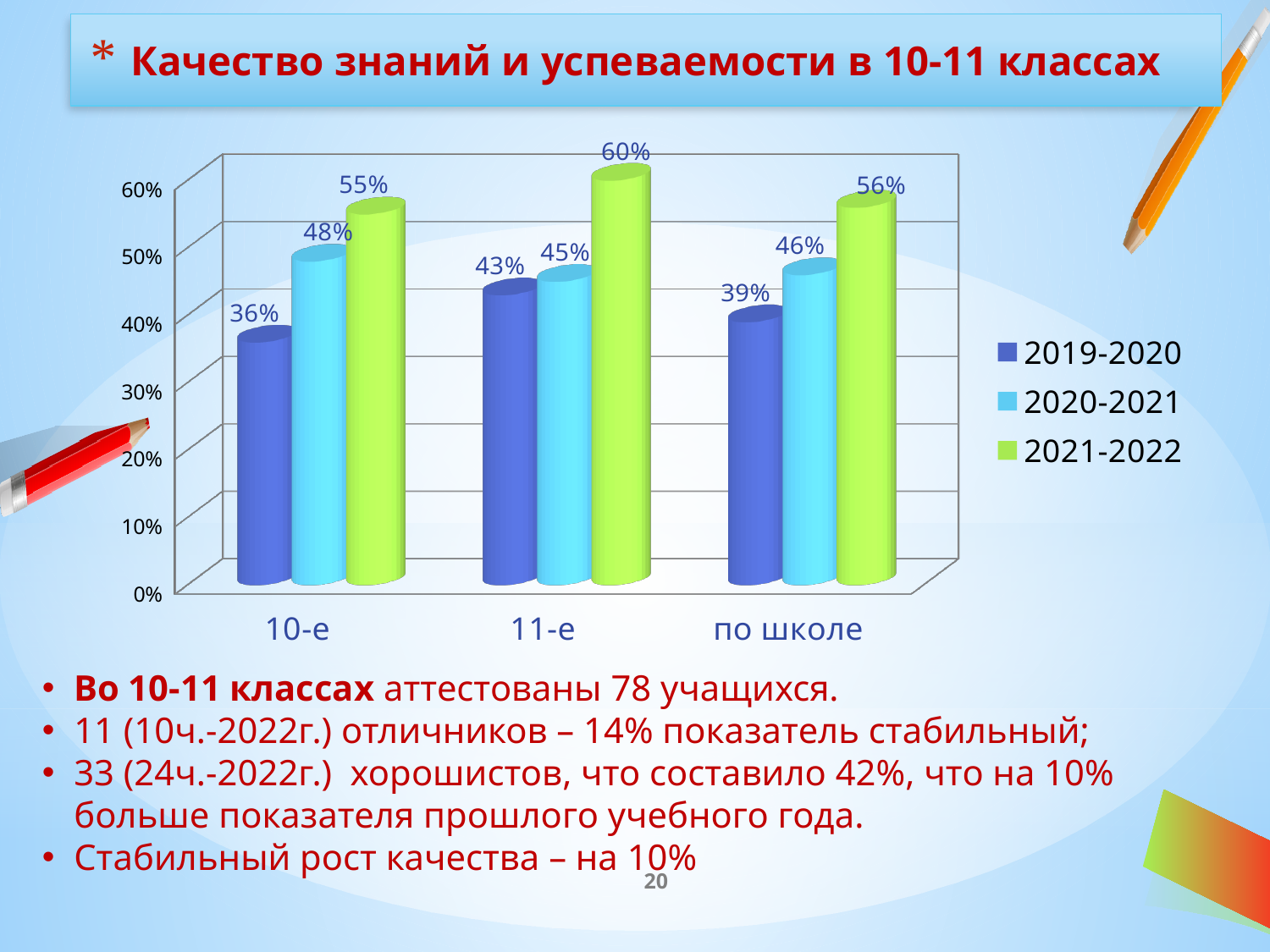
What is the difference between the 2021-2022 and 2019-2020 values for 10-е? 19% How many categories are shown on the x axis? 3 Which category has the highest value in the 2021-2022 series? 11-е How many series does the legend list? 3 What is the value for 11-е in the 2021-2022 series? 60% Which is larger for по школе: the 2020-2021 value or the 2021-2022 value? 2021-2022 What kind of chart is shown on the slide? bar chart Which category has the lowest value in the 2019-2020 series? 10-е What is the value for по школе in the 2020-2021 series? 46% What is the value for 10-е in the 2019-2020 series? 36% Do the values for 11-е rise or fall from 2019-2020 to 2021-2022? rise Is the 2019-2020 value for 11-е greater or less than 40%? greater